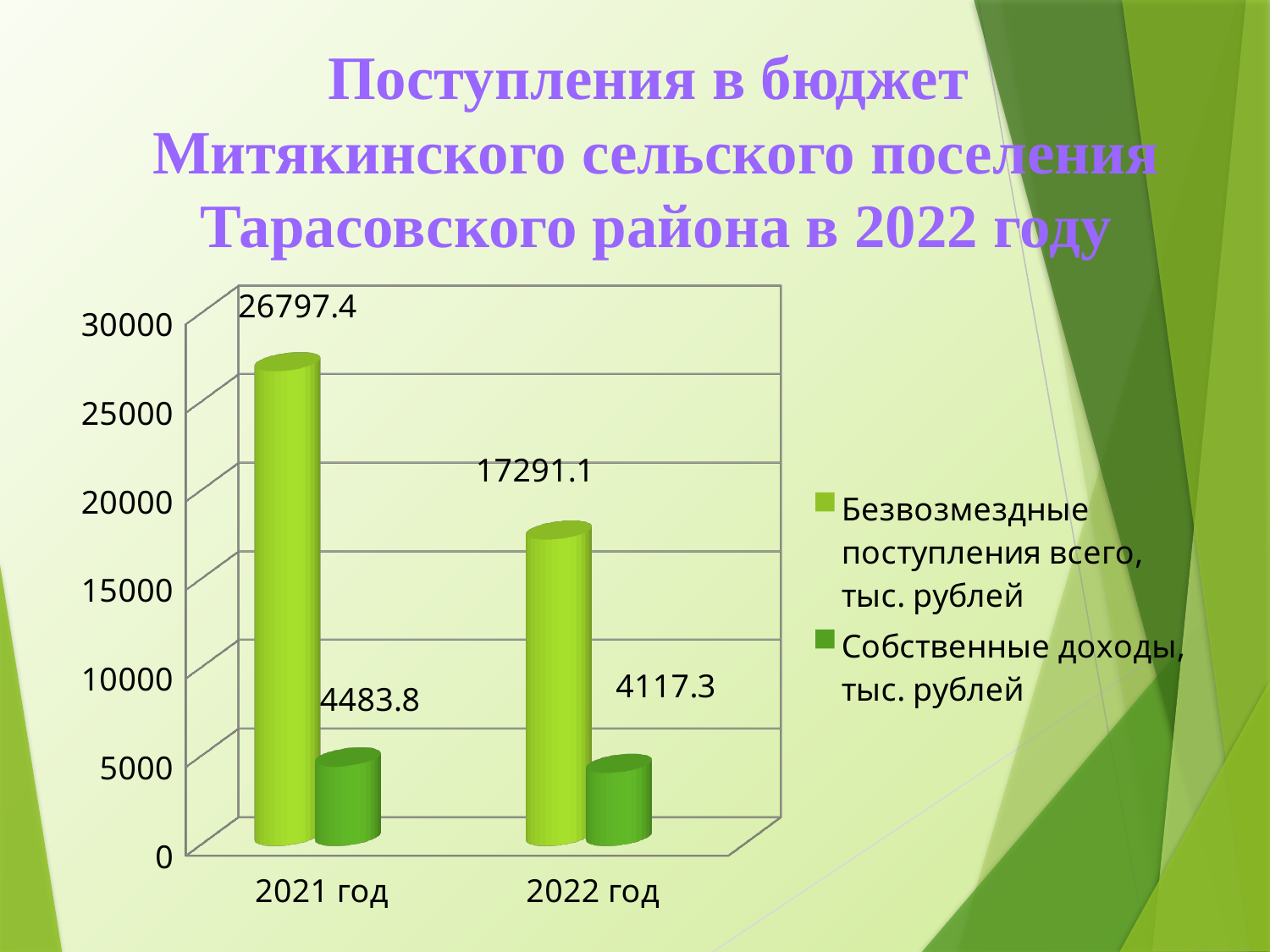
What is the value of Безвозмездные поступления всего, тыс. рублей for 2022 год? 17291.1 What is the value of Собственные доходы, тыс. рублей for 2022 год? 4117.3 By how much did Безвозмездные поступления всего, тыс. рублей decrease from 2021 год to 2022 год? 9506.3 What is the value of Собственные доходы, тыс. рублей for 2021 год? 4483.8 What is the difference between Безвозмездные поступления всего and Собственные доходы in 2022 год? 13173.8 Is the value for Собственные доходы, тыс. рублей in 2021 год greater or less than 5000? less Do the values for Безвозмездные поступления всего, тыс. рублей rise or fall from 2021 год to 2022 год? fall What is the value of Безвозмездные поступления всего, тыс. рублей for 2021 год? 26797.4 Which year has the lower value for Собственные доходы, тыс. рублей? 2022 год What kind of chart is shown on the slide? bar chart Which year has the higher value for Безвозмездные поступления всего, тыс. рублей? 2021 год How many series does the legend list? 2